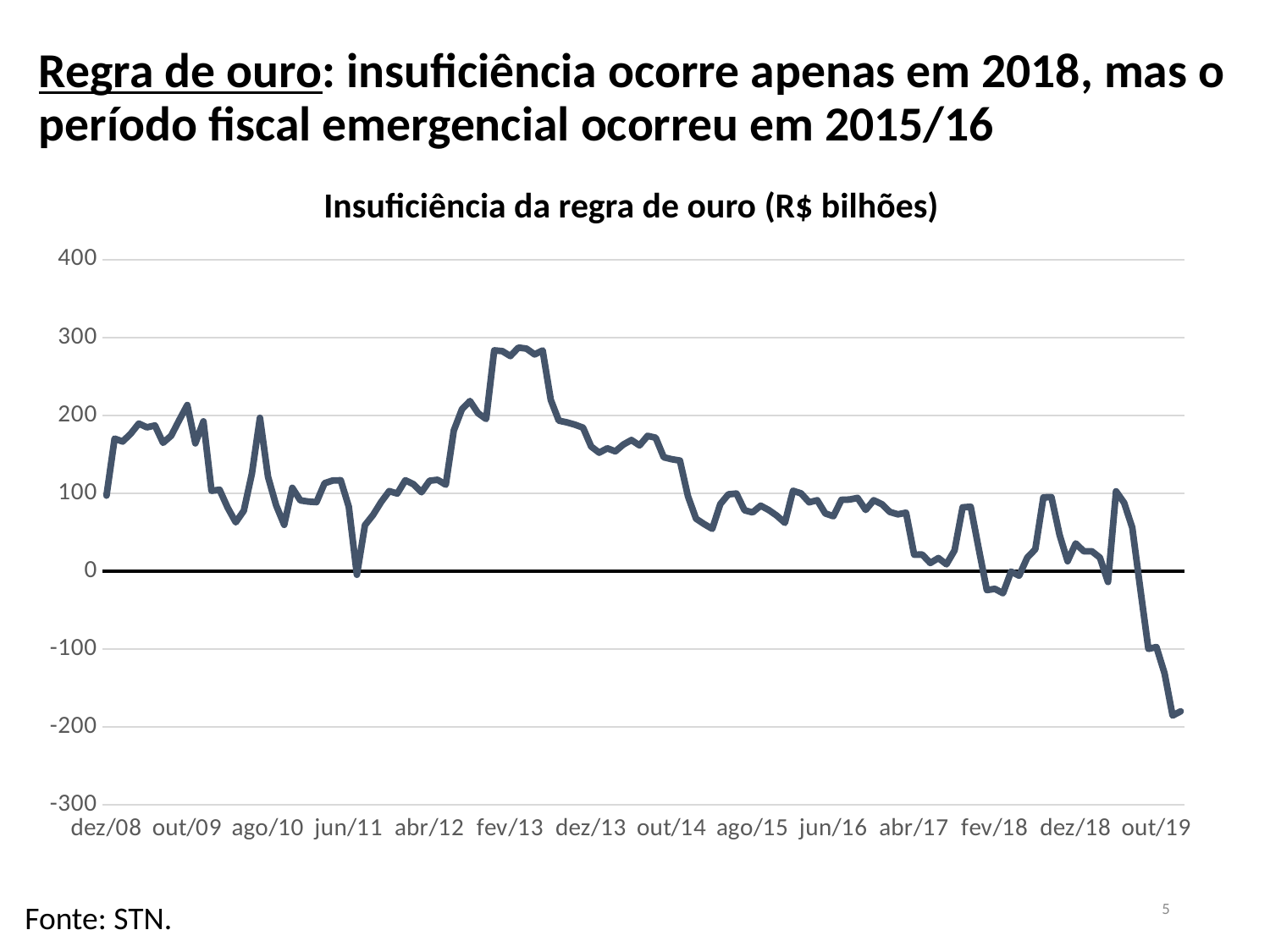
How many date labels are shown along the x axis of the chart? 14 What kind of chart is shown on the slide? line chart At which x-axis label does the line reach its lowest value? out/19 What is the title of the chart? Insuficiência da regra de ouro (R$ bilhões) Is the value around fev/13 greater or less than 300? less Is the value around fev/13 greater or less than 200? greater Around which x-axis label does the line reach its highest value? fev/13 Overall, do the values rise or fall from dez/08 to out/19? fall Is the value around fev/13 larger or smaller than the value at out/19? larger Is the value around out/14 greater or less than 100? greater